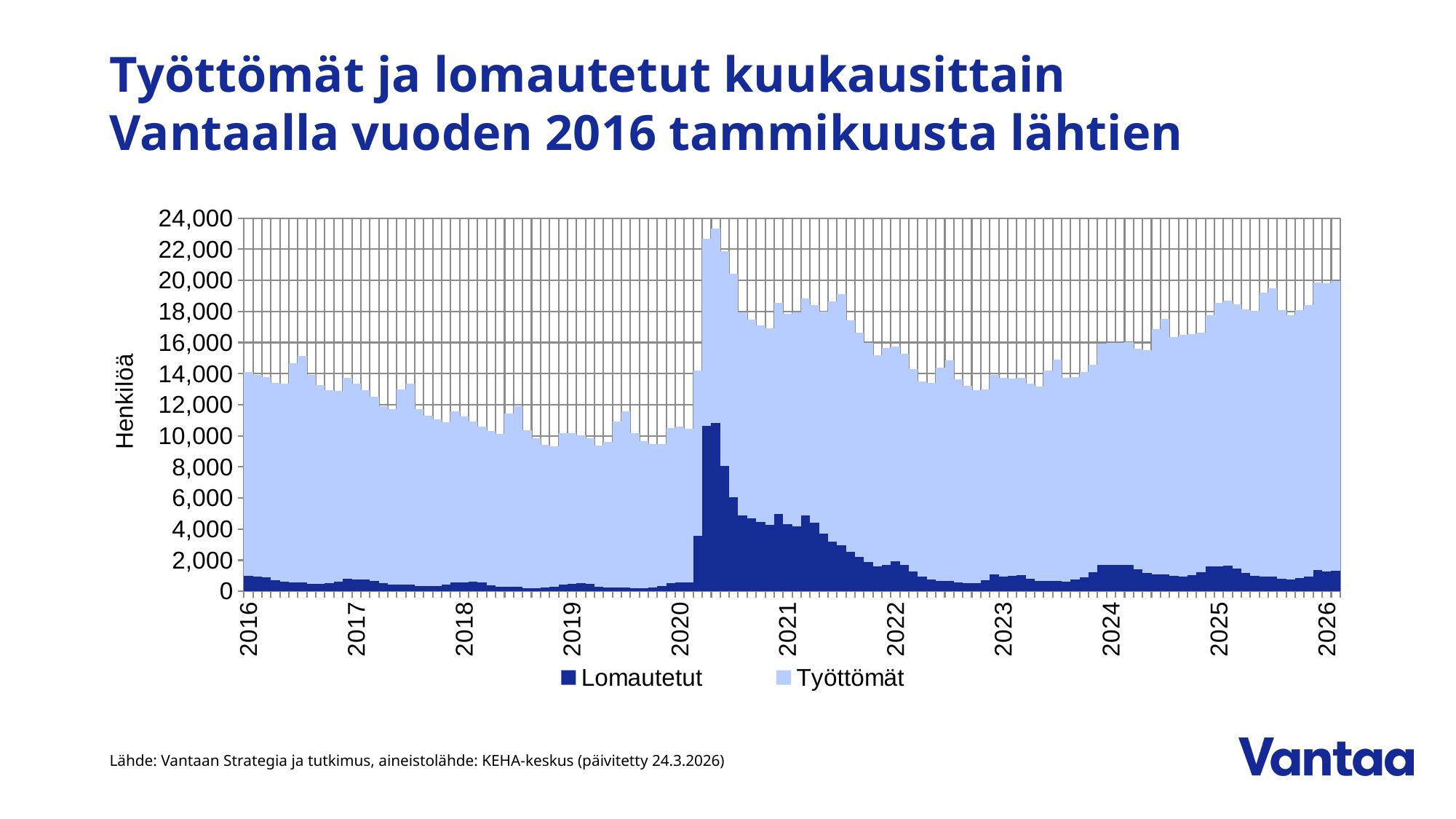
Does the total number of people rise or fall from 2023 to 2026? rise Which is larger: the Lomautetut value in mid-2020 or the Lomautetut value in mid-2018? mid-2020 Is the highest total value in 2020 greater or less than 22,000? greater What are the two series named in the legend? Lomautetut and Työttömät How many series does the legend list? 2 What kind of chart is shown on the slide? Stacked bar chart Is the peak value of Lomautetut in 2020 greater or less than 10,000? greater Is the value for Lomautetut at the start of 2018 greater or less than 2,000? less In which year does the total of unemployed and laid-off people reach its highest peak? 2020 Does the total number of people rise or fall from 2016 to 2019? fall What is the label on the vertical axis? Henkilöä